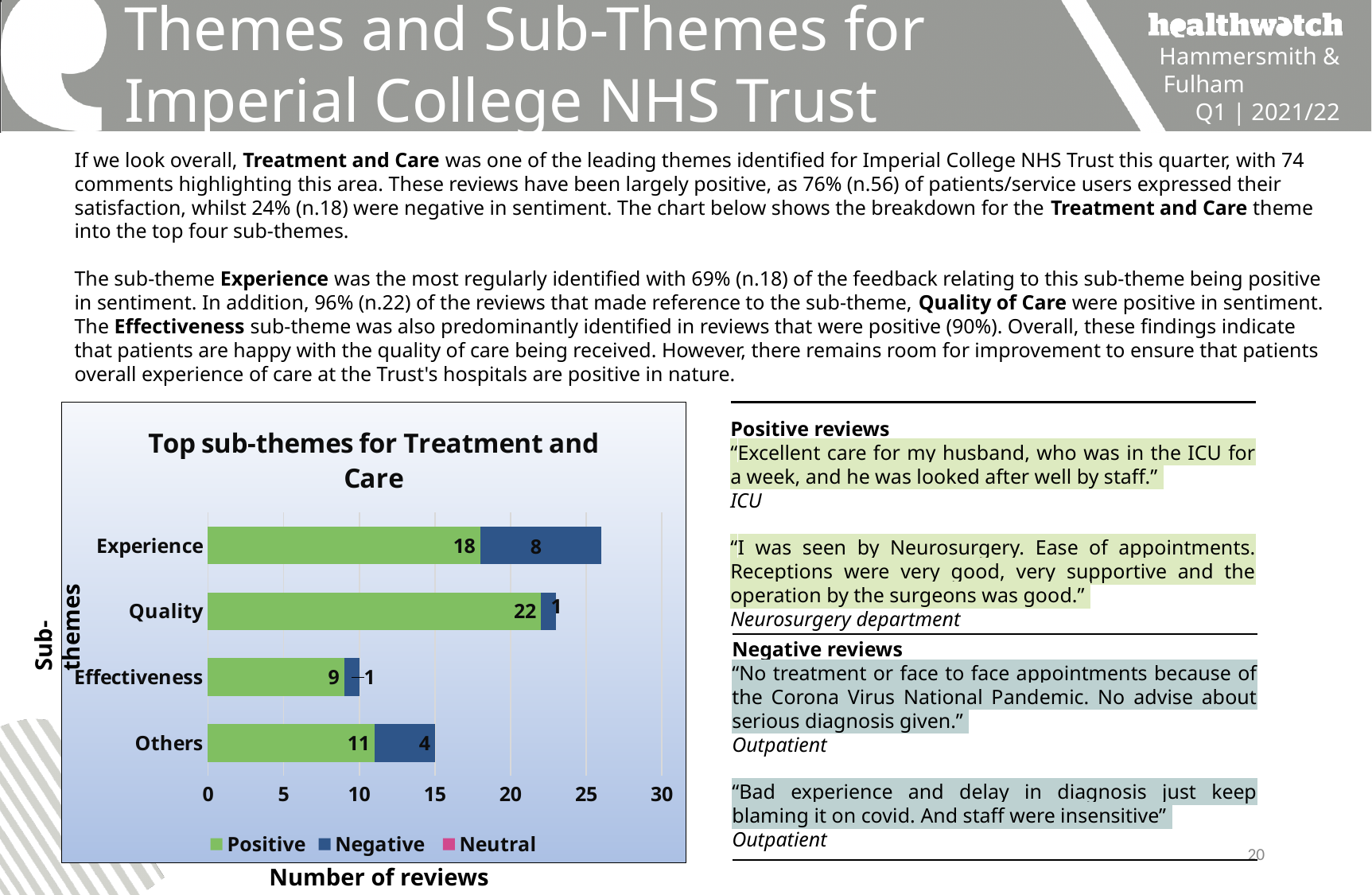
What is the Negative value for Experience? 8 What is the total number of reviews for Experience (Positive plus Negative)? 26 What type of chart is shown on the slide? Stacked bar chart How many sub-theme categories are plotted on the chart? 4 What is the Positive value for Experience? 18 What is the Negative value for Others? 4 Which sub-theme has the lowest Positive value? Effectiveness What is the title of the chart? Top sub-themes for Treatment and Care What is the Positive value for Quality? 22 What is the difference between the Positive values for Quality and Effectiveness? 13 How many series does the chart legend list? 3 Which sub-theme has the highest Positive value? Quality